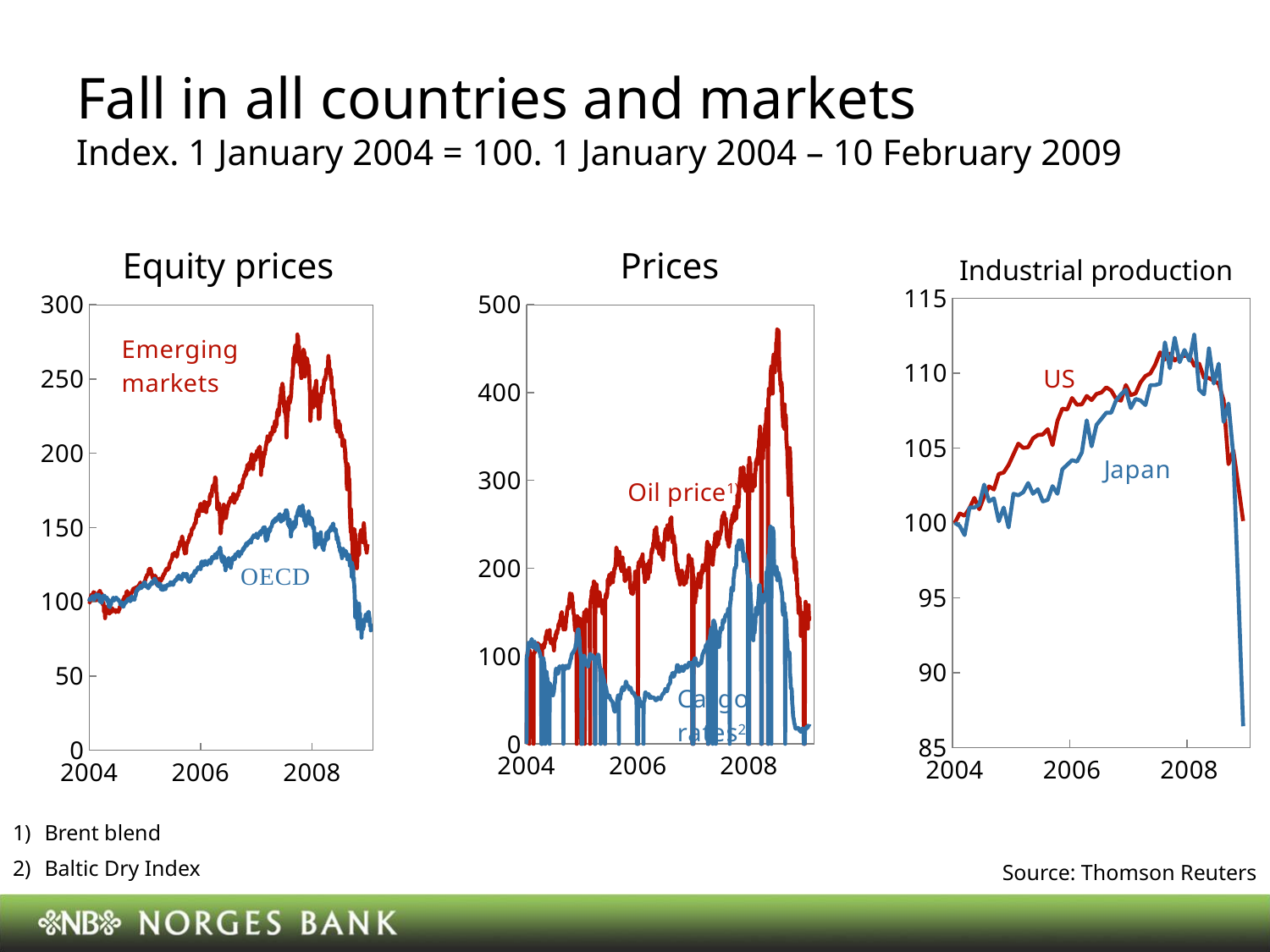
What kind of chart is the Equity prices chart? line chart How many charts are shown on the slide? 3 On the Industrial production chart, is the final value for Japan greater or less than 90? less On the Industrial production chart, does the US series rise or fall between 2004 and 2007? rise On the Equity prices chart, is the peak value of OECD greater or less than 200? less How many series are plotted on the Equity prices chart? 2 On the Equity prices chart, at the end of the period, which series is higher, Emerging markets or OECD? Emerging markets On the Prices chart, is the peak value of Oil price greater or less than 400? greater On the Prices chart, which series reaches a higher peak, Oil price or Cargo rates? Oil price On the Prices chart, what does footnote 1 say the Oil price series refers to? Brent blend On the Industrial production chart, at the end of the period, which series is higher, US or Japan? US